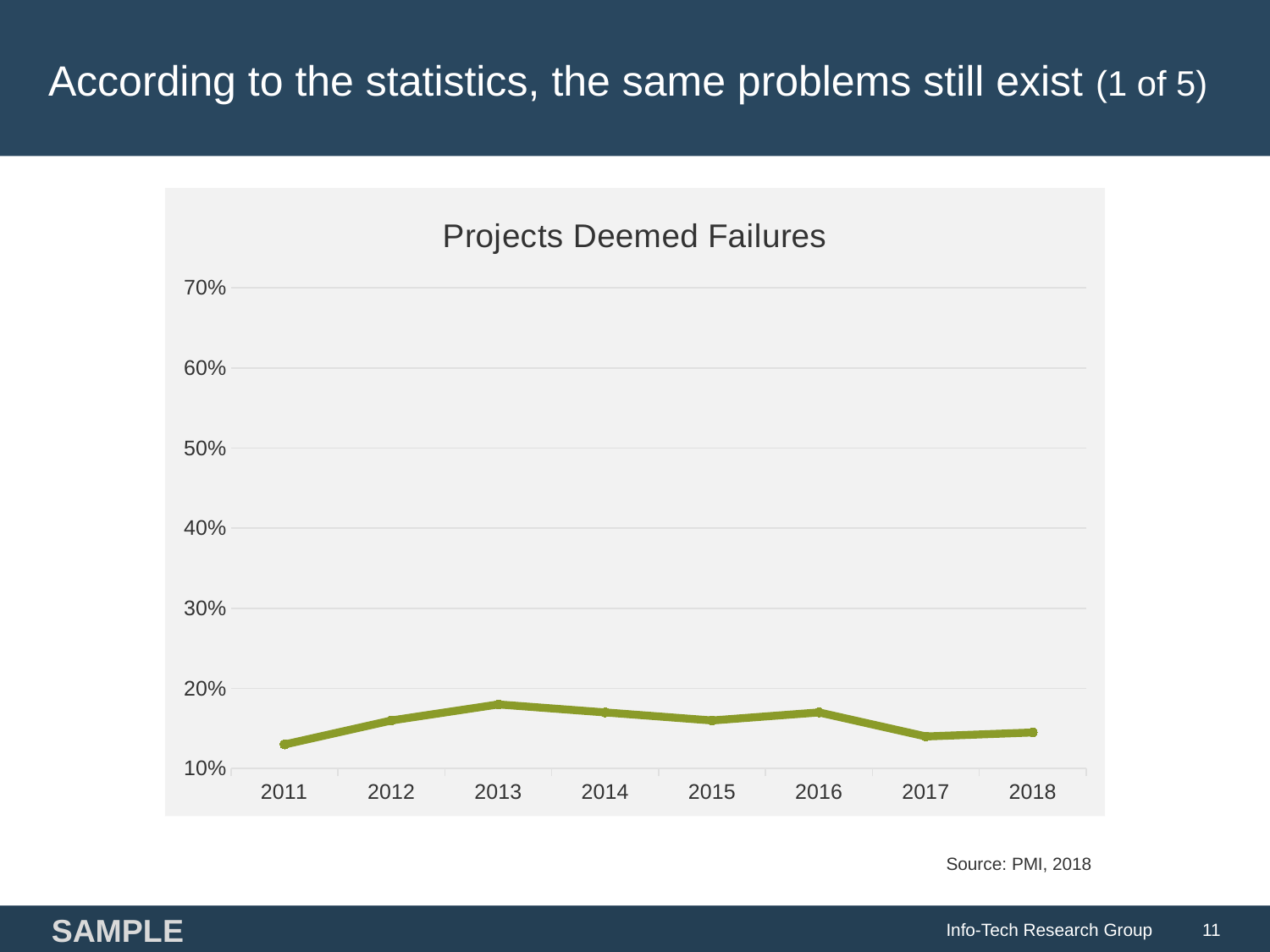
Do the values rise or fall from 2016 to 2017? fall Which is larger, the value for 2013 or the value for 2017? 2013 Is the value for 2016 greater or less than 30%? less Which year has the highest value for Projects Deemed Failures? 2013 Which is larger, the value for 2011 or the value for 2012? 2012 Is the value for 2013 greater or less than 20%? less How many years are plotted on the x axis of the chart? 8 Is the value for 2011 greater or less than 10%? greater What kind of chart is shown on the slide? line chart What is the title of the chart? Projects Deemed Failures What is the first year shown on the x axis of the chart? 2011 Do the values rise or fall from 2011 to 2013? rise